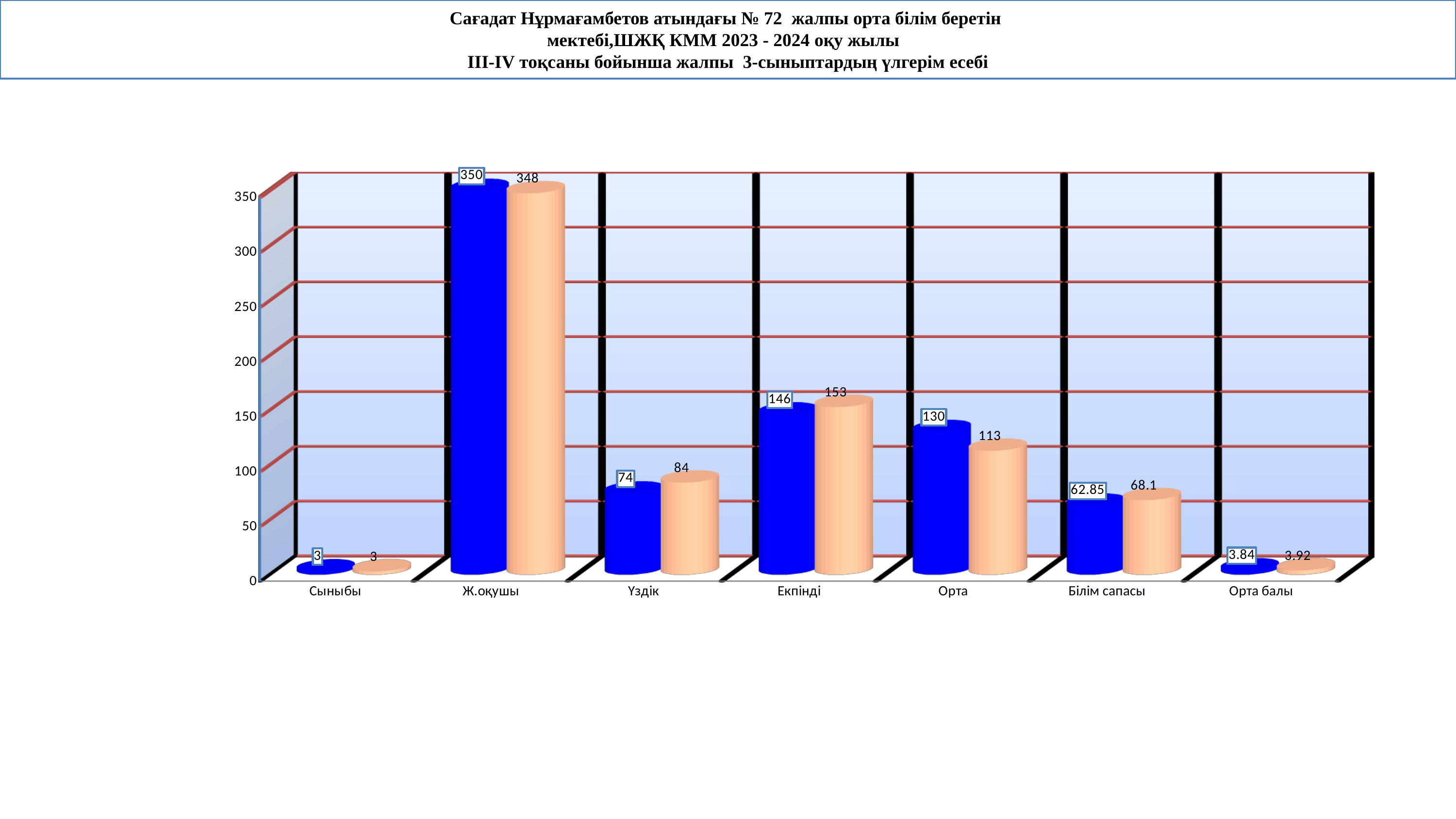
Which category has the highest blue bar? Ж.оқушы What is the difference between the orange bar and the blue bar for Екпінді? 7 What is the difference between the blue bar and the orange bar for Орта? 17 Which category has the lowest orange bar? Сыныбы How many categories are shown on the x axis? 7 What is the value of the blue bar for Білім сапасы? 62.85 What is the value of the orange bar for Орта балы? 3.92 Is the value of the orange bar for Орта greater or less than 100? greater What kind of chart is shown on the slide? bar chart What is the value of the blue bar for Ж.оқушы? 350 For Үздік, which bar is larger, the blue one or the orange one? the orange one What is the value of the orange bar for Үздік? 84